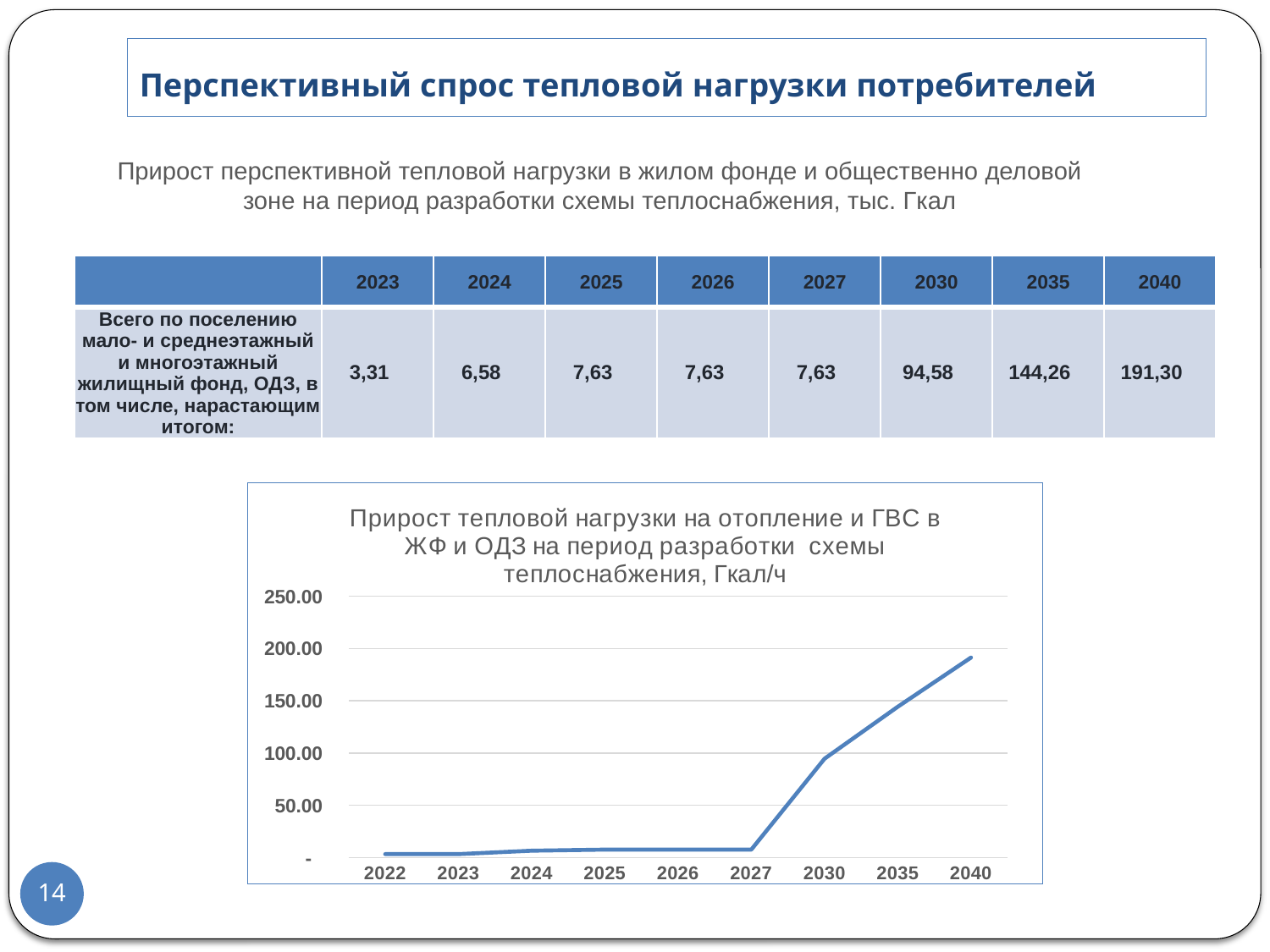
Is the value for 2027 on the chart greater or less than 50.00? less How many years are marked on the x axis of the chart? 9 What kind of chart is shown on the slide? line chart What unit is named at the end of the chart title? Гкал/ч Do the values on the chart rise or fall from 2022 to 2040? rise Is the value for 2035 on the chart greater or less than 100.00? greater Is the value for 2040 on the chart greater or less than 150.00? greater Which year has the highest value on the chart? 2040 What is the highest tick value shown on the y axis of the chart? 250.00 Which is larger on the chart, the value for 2035 or the value for 2040? 2040 Which is larger on the chart, the value for 2027 or the value for 2030? 2030